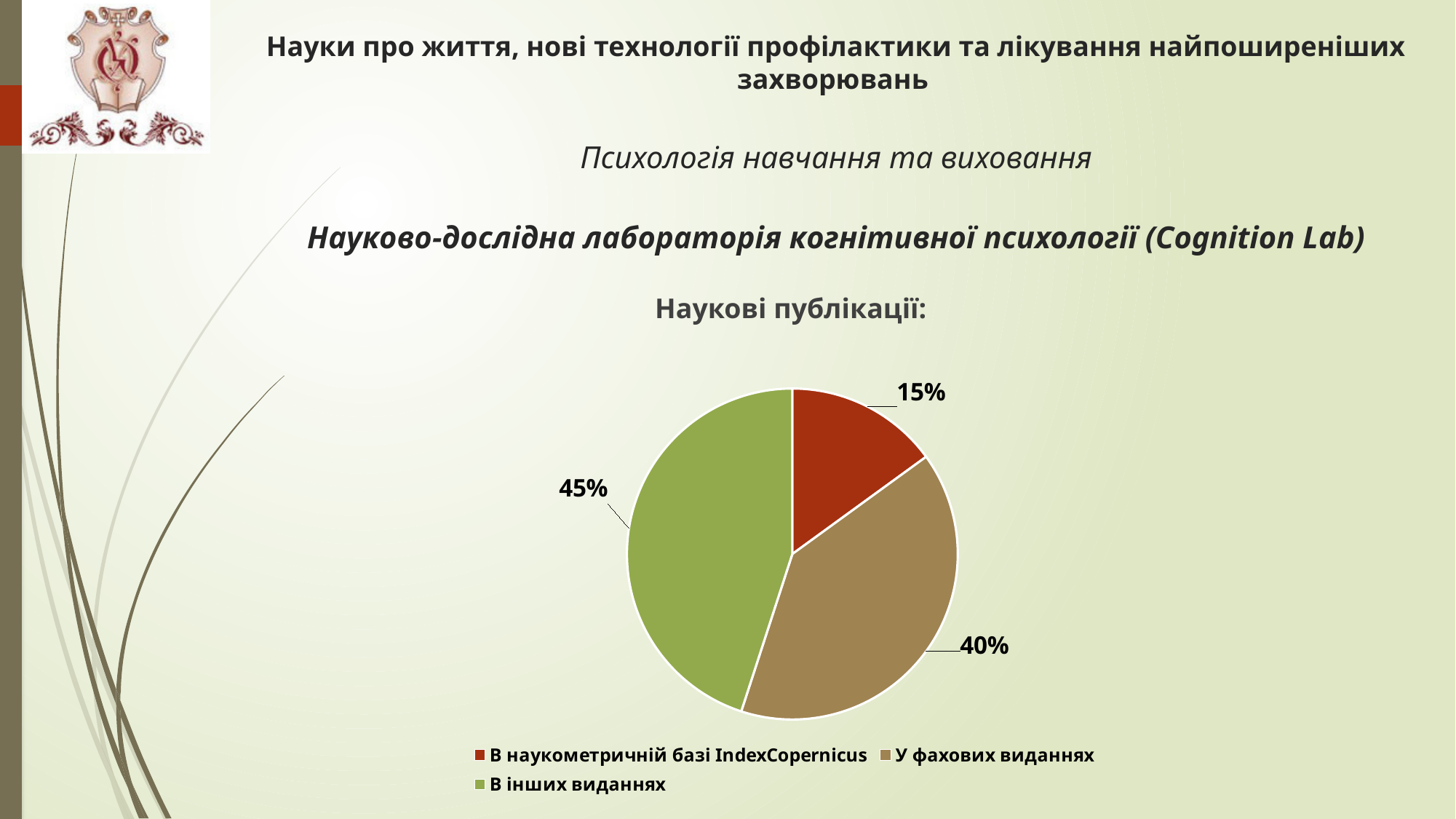
What is the difference in percentage points between "В інших виданнях" and "У фахових виданнях"? 5 How many entries does the legend list? 3 What share of the pie does "В наукометричній базі IndexCopernicus" have? 15% How many slices does the pie chart have? 3 What share of the pie does "У фахових виданнях" have? 40% What is the difference in percentage points between "В інших виданнях" and "В наукометричній базі IndexCopernicus"? 30 Which is larger: the slice for "У фахових виданнях" or the slice for "В наукометричній базі IndexCopernicus"? У фахових виданнях What colour is the slice for "В інших виданнях"? green What kind of chart is shown on the slide? pie chart What share of the pie does "В інших виданнях" have? 45% Which category has the smallest slice of the pie? В наукометричній базі IndexCopernicus Which category has the largest slice of the pie? В інших виданнях